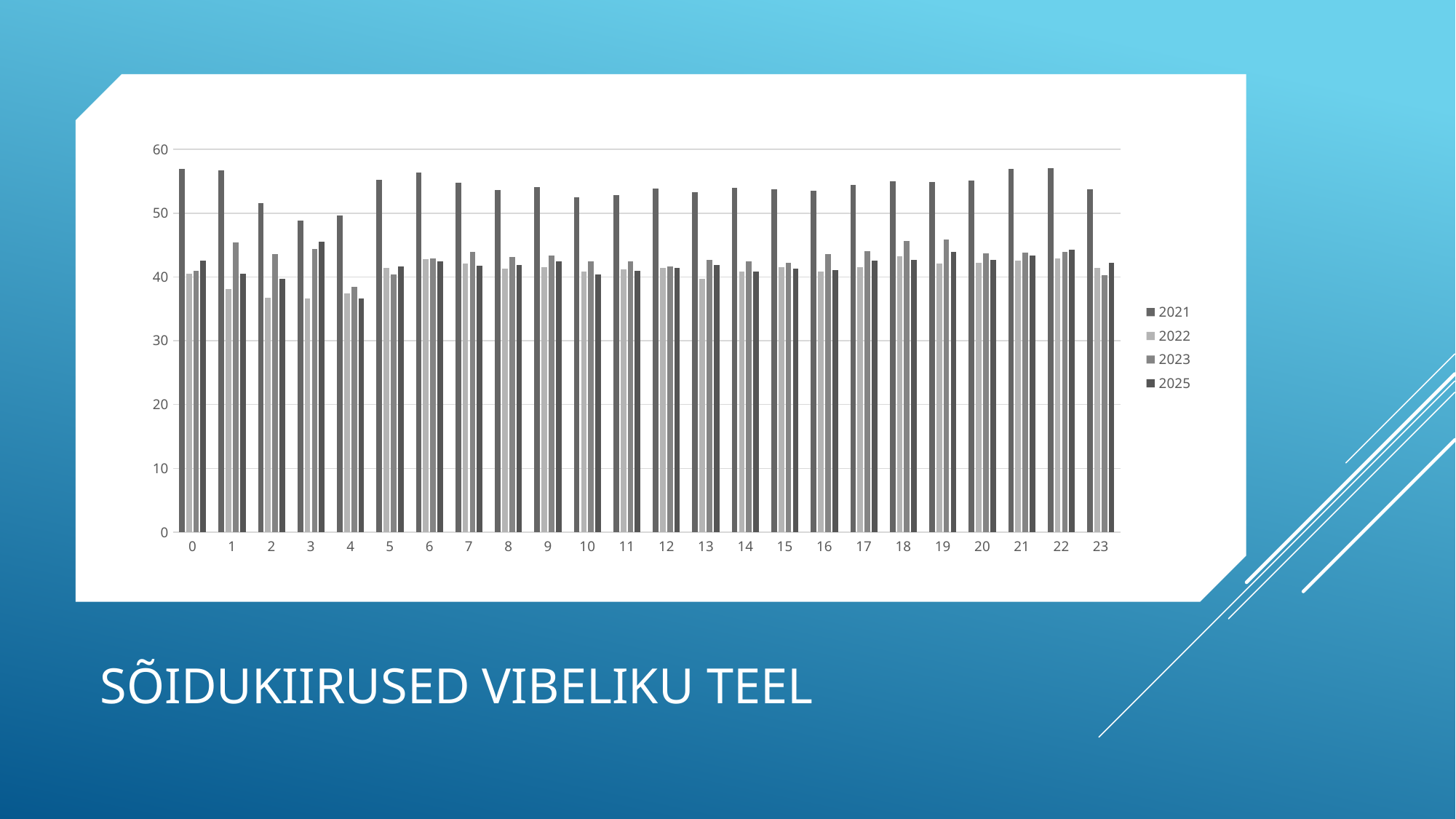
At category 0, which is larger: the value for 2021 or the value for 2022? 2021 How many categories are shown along the x axis? 24 Is the value for 2025 at category 4 greater or less than 40? less How many series does the legend list? 4 At category 1, which is larger: the value for 2023 or the value for 2022? 2023 Which years are listed in the legend? 2021, 2022, 2023, 2025 Is the value for 2021 at category 0 greater or less than 50? greater What is the title text shown below the chart? SÕIDUKIIRUSED VIBELIKU TEEL Is the value for 2022 at category 2 greater or less than 40? less Which series has the highest value at category 5? 2021 What kind of chart is shown on the slide? bar chart